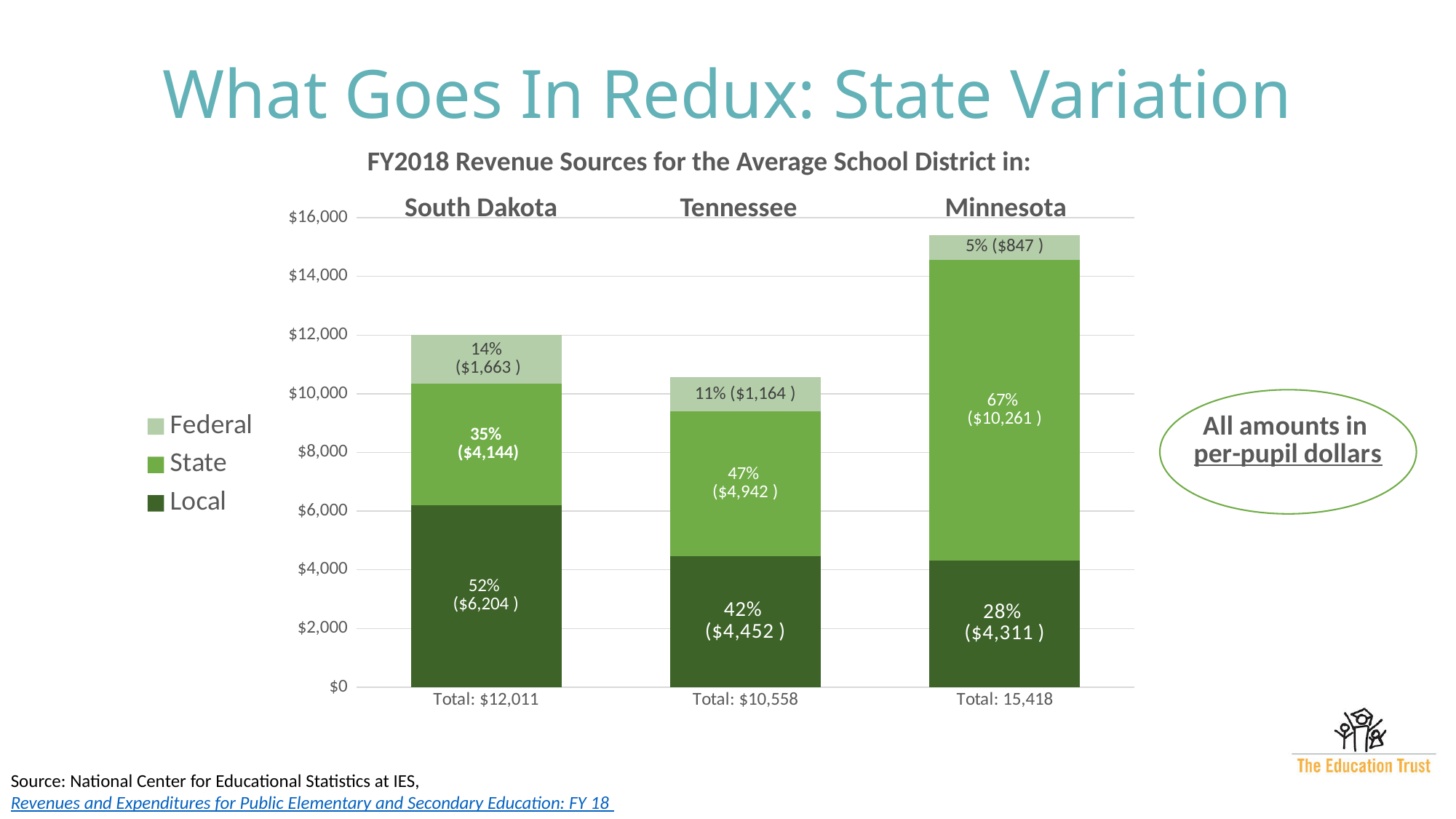
What kind of chart is shown on the slide? Stacked bar chart What is the difference between Minnesota's State revenue and Tennessee's State revenue per pupil? $5,319 Is the total bar for Tennessee greater or less than $12,000? less How many series does the legend list? 3 What is the total per-pupil revenue for South Dakota? $12,011 What is the Local revenue amount per pupil for South Dakota? $6,204 What percentage of Tennessee's revenue comes from State sources? 47% How many states are shown in the chart? 3 Which is larger, the Local revenue for Tennessee or the Local revenue for Minnesota? Tennessee Which state has the highest total per-pupil revenue? Minnesota Which state has the lowest total per-pupil revenue? Tennessee What is the Federal revenue amount per pupil for Minnesota? $847